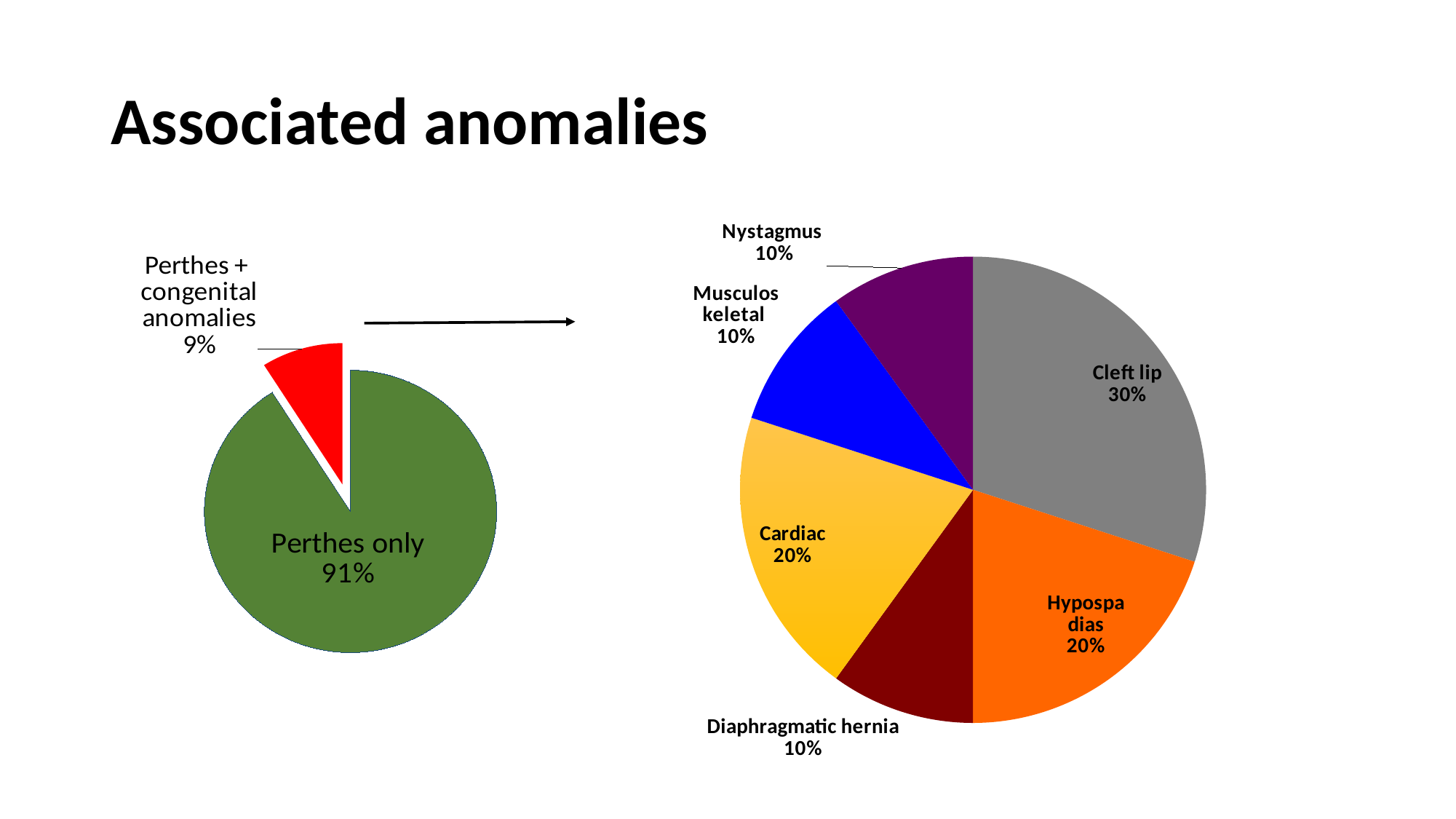
In the left pie chart, how many slices are there? 2 In the right pie chart, what is the difference between the Cleft lip share and the Cardiac share? 10% In the right pie chart, which is larger, the Cardiac slice or the Nystagmus slice? Cardiac In the left pie chart, what share is labelled for Perthes only? 91% In the right pie chart, what share is labelled for Hypospadias? 20% In the right pie chart, what share is labelled for Diaphragmatic hernia? 10% In the left pie chart, what share is labelled for Perthes + congenital anomalies? 9% In the left pie chart, what colour is the Perthes only slice? Green In the right pie chart, what share is labelled for Cleft lip? 30% In the right pie chart, which anomaly has the largest slice? Cleft lip What kind of chart is the chart on the right of the slide? Pie chart In the right pie chart, how many slices are there? 6